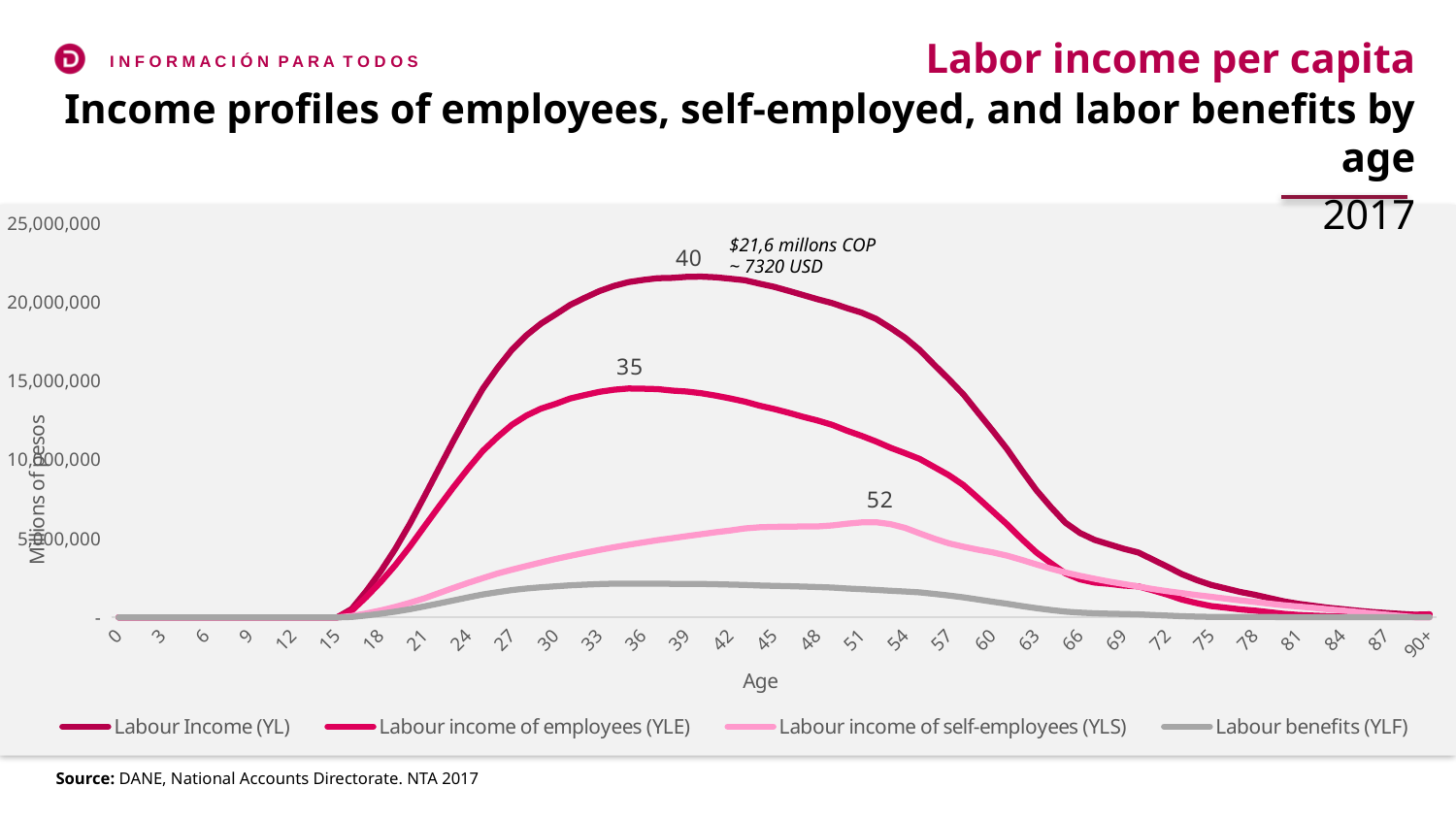
At what age does the Labour income of employees (YLE) series reach its peak, according to the label on the chart? 35 At what age does the Labour income of self-employees (YLS) series reach its peak, according to the label on the chart? 52 Is the peak value of Labour Income (YL) at age 40 greater or less than 20,000,000? greater Which series has the lowest peak value on the chart? Labour benefits (YLF) Is the peak value of Labour income of self-employees (YLS) at age 52 greater or less than 5,000,000? greater How many series does the chart legend list? 4 What kind of chart is shown on the slide? Line chart Does the Labour Income (YL) series rise or fall between age 40 and age 90+? Fall At what age does the Labour Income (YL) series reach its peak, according to the label on the chart? 40 Which series reaches the highest peak value on the chart? Labour Income (YL) At age 45, which is larger: Labour Income (YL) or Labour income of employees (YLE)? Labour Income (YL) What is the label on the x axis of the chart? Age